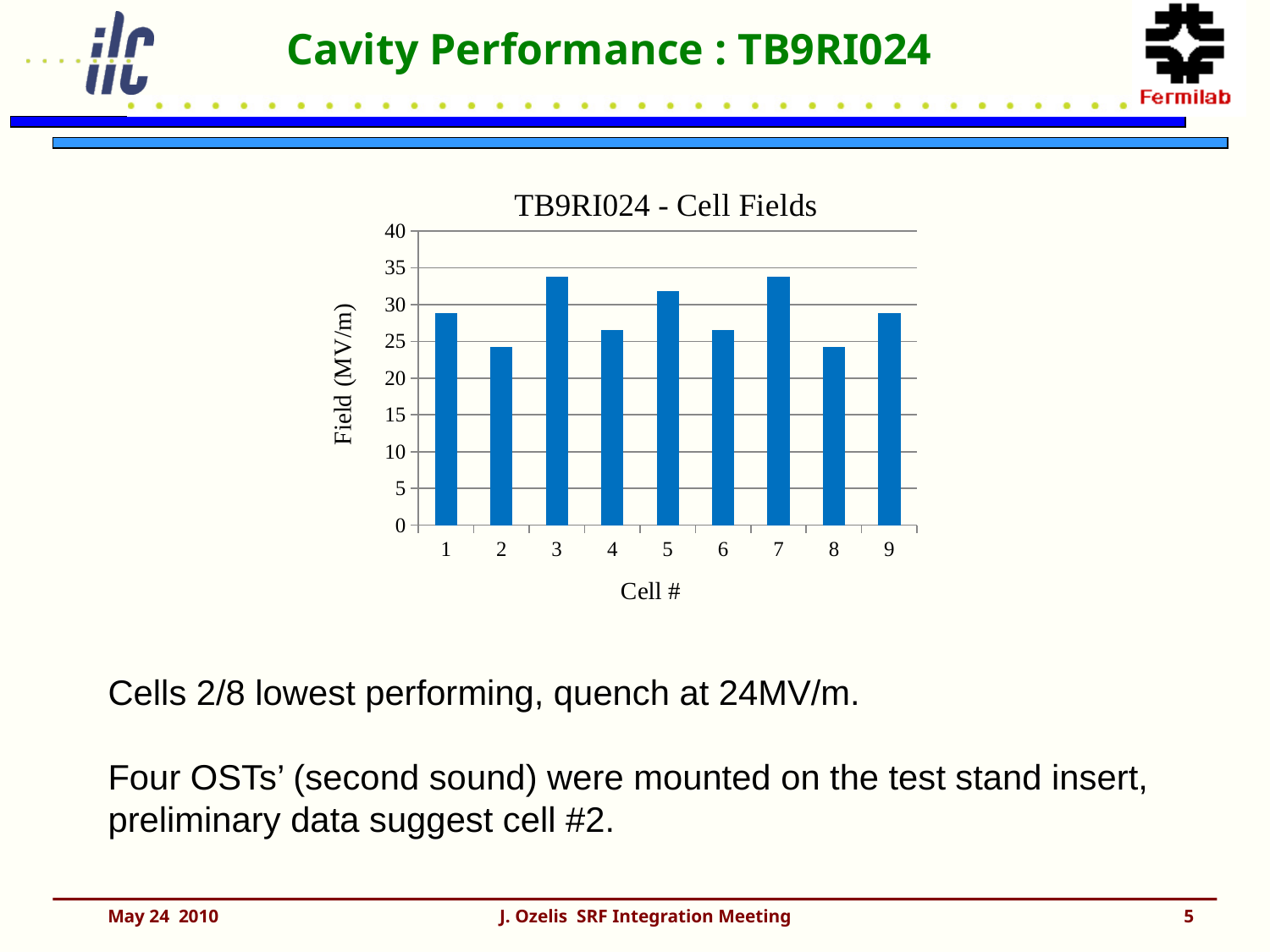
Is the value for cell 8 greater or less than 20? greater Is the value for cell 3 greater or less than 30? greater Is the value for cell 5 greater or less than 30? greater Which has the larger field value, cell 3 or cell 2? cell 3 What is the title of the chart? TB9RI024 - Cell Fields Which has the larger field value, cell 5 or cell 4? cell 5 How many cells are plotted on the x axis of the chart? 9 Which has the larger field value, cell 8 or cell 9? cell 9 What kind of chart is shown on the slide? bar chart What is the label of the y axis of the chart? Field (MV/m)